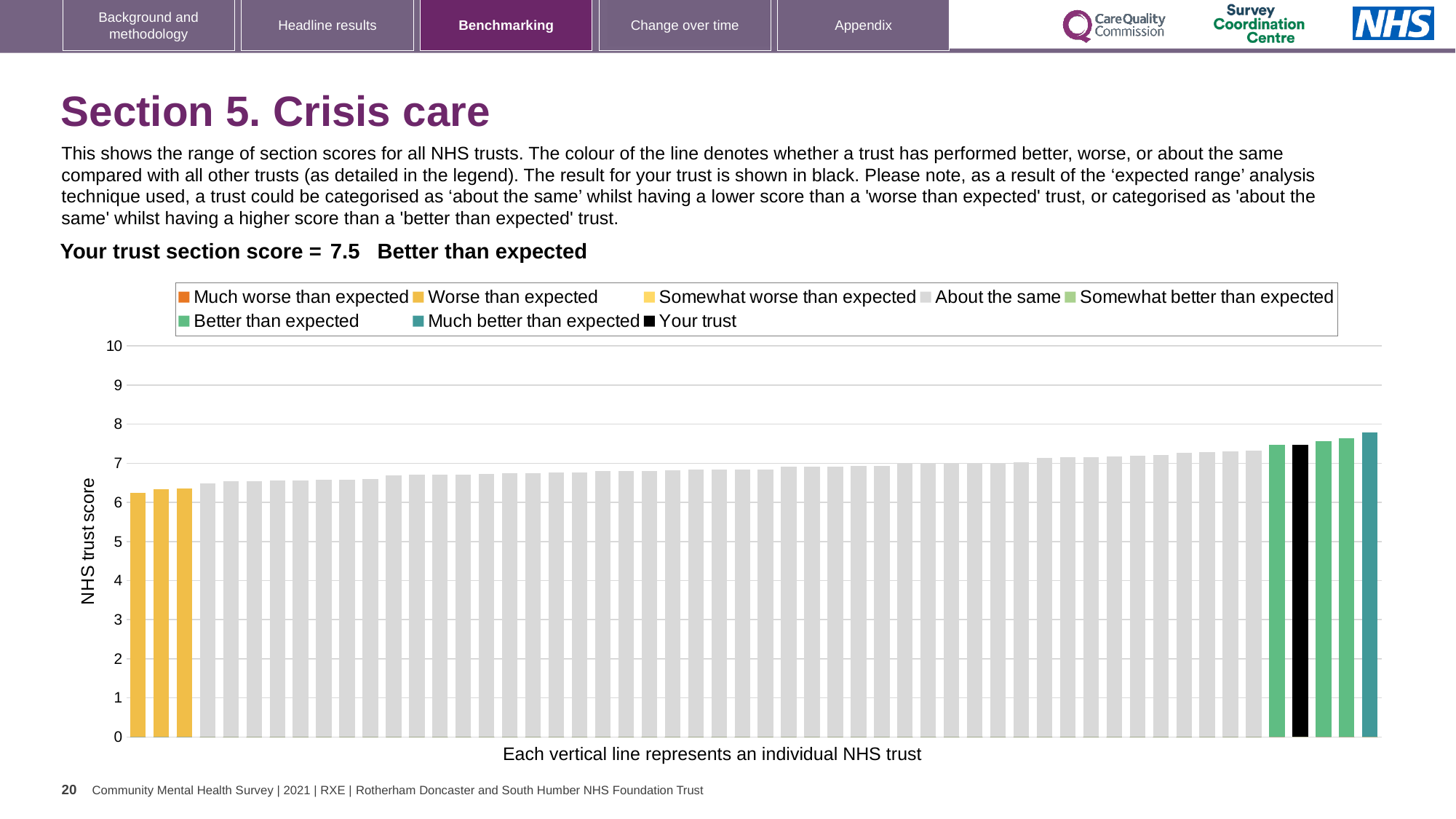
What is the section score for your trust shown on the slide? 7.5 Is the value of the lowest bar in the chart greater or less than 6? greater Is the value of the tallest bar in the chart greater or less than 8? less What is the label on the y axis of the chart? NHS trust score Do the bar values rise or fall from left to right along the x axis? rise Is the value of the black bar (your trust) greater or less than 7? greater Which is larger: the value of the black bar (your trust) or the value of the leftmost bar? the black bar (your trust) What kind of chart is shown on the slide? bar chart How many entries does the chart legend list? 8 How many bars are coloured in the 'Worse than expected' colour (yellow)? 3 Which legend category does the tallest bar in the chart belong to? Much better than expected